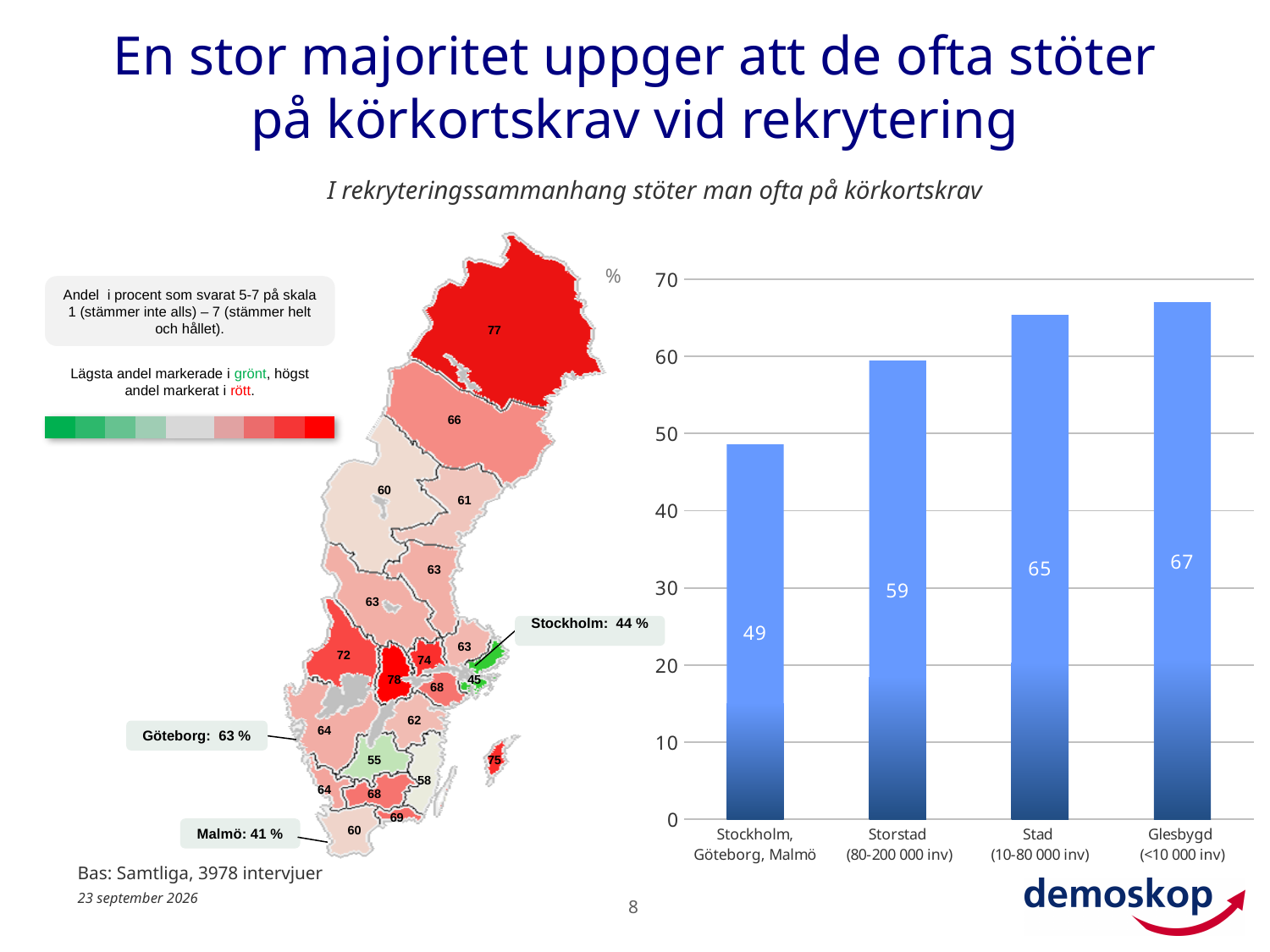
In the bar chart, what is the difference between the values for Glesbygd (<10 000 inv) and Stockholm, Göteborg, Malmö? 18 On the map, what percentage is shown for Stockholm? 44 % In the bar chart, which is larger: the value for Stad (10-80 000 inv) or the value for Storstad (80-200 000 inv)? Stad (10-80 000 inv) What kind of chart is shown on the right side of the slide? bar chart In the bar chart, which category has the highest value? Glesbygd (<10 000 inv) In the bar chart, which category has the lowest value? Stockholm, Göteborg, Malmö In the bar chart, do the values rise or fall from left to right along the x axis? rise In the bar chart, what is the value for Stockholm, Göteborg, Malmö? 49 How many categories are shown in the bar chart? 4 In the bar chart, what is the value for Glesbygd (<10 000 inv)? 67 In the bar chart, is the value for Stad (10-80 000 inv) greater or less than 60? greater In the bar chart, what is the value for Storstad (80-200 000 inv)? 59